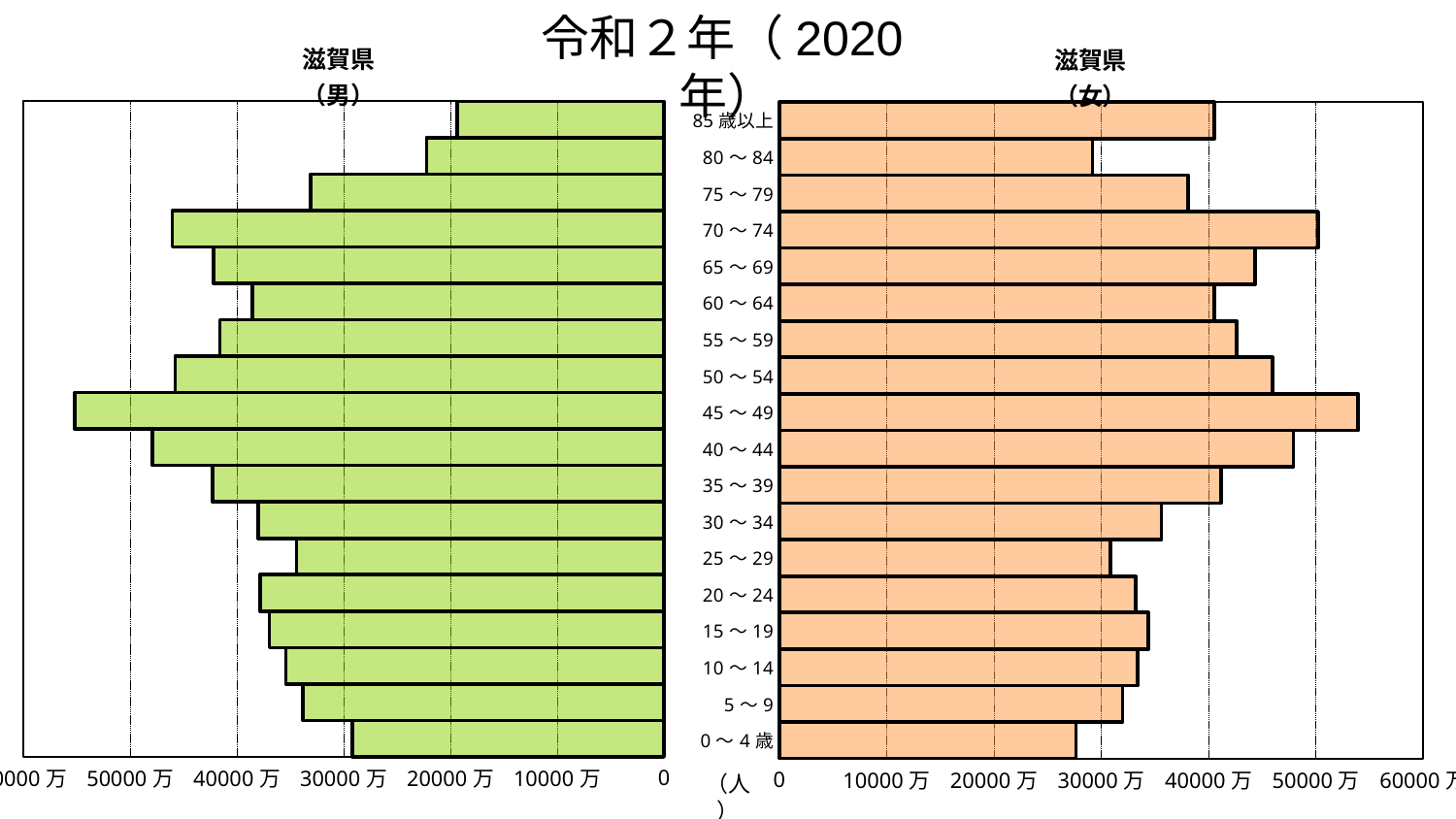
In the 滋賀県（男） chart, which age group has the highest value? 45～49 What colour are the bars in the 滋賀県（女） chart? orange In the 滋賀県（女） chart, is the value for 0～4歳 greater or less than 30000万? less In the 滋賀県（女） chart, is the value for 40～44 greater or less than 50000万? less In the 滋賀県（男） chart, is the value for 70～74 greater or less than 40000万? greater What kind of chart is shown on the slide? bar chart In the 滋賀県（男） chart, which age group has the lowest value? 85歳以上 What is the title shown at the top of the slide? 令和２年（2020年） In the 滋賀県（女） chart, which is larger, the value for 45～49 or the value for 0～4歳? 45～49 How many age groups are plotted in the 滋賀県（男） chart? 18 In the 滋賀県（女） chart, which age group has the highest value? 45～49